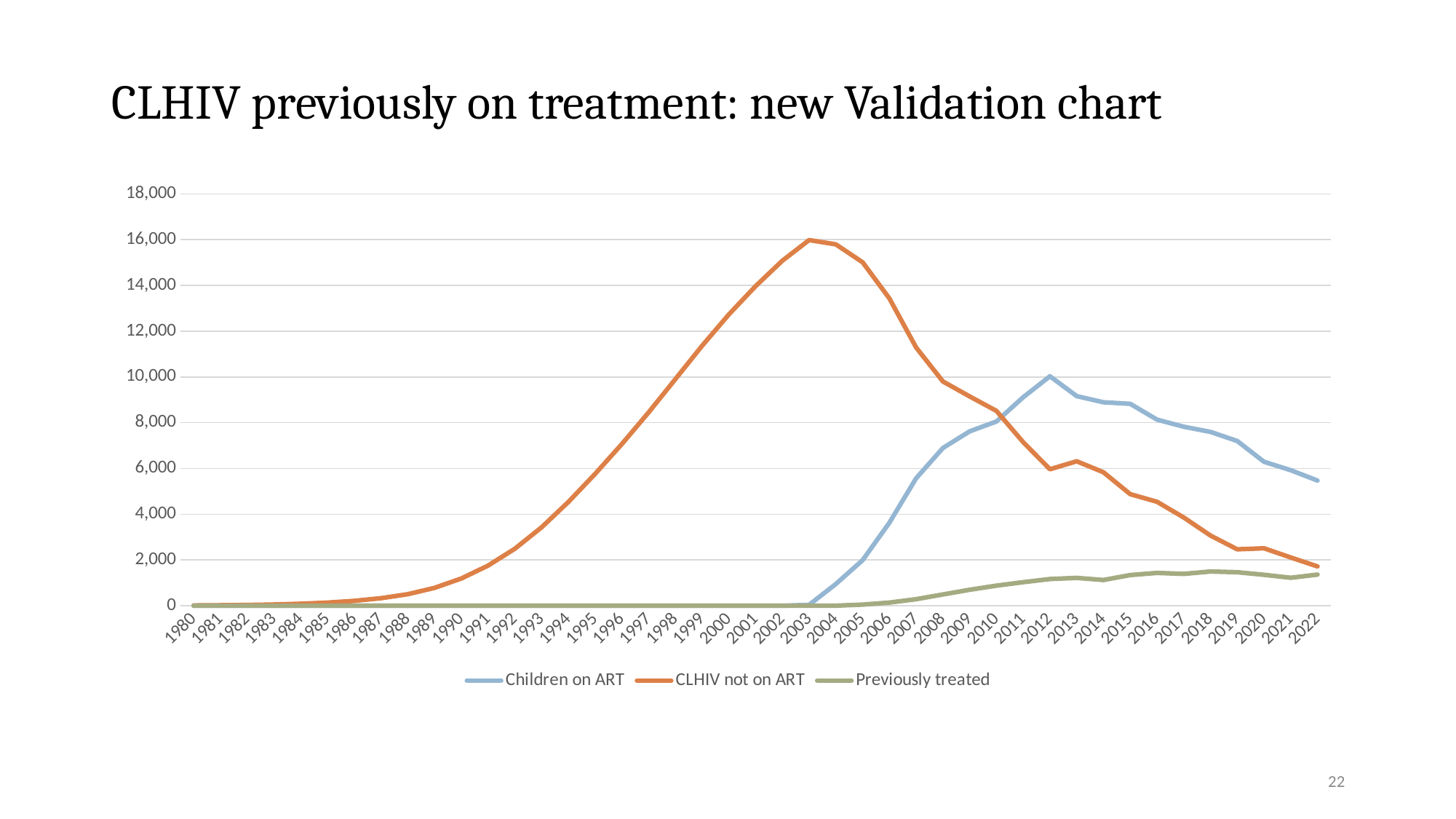
Is the value for CLHIV not on ART in 2003 greater or less than 14,000? greater How many series does the legend list? 3 In which year does the CLHIV not on ART series reach its highest value? 2003 Is the value for Children on ART in 2012 greater or less than 8,000? greater Which series has the larger value in 2000, Children on ART or CLHIV not on ART? CLHIV not on ART How many years are shown along the x axis? 43 Which series has the larger value in 2022, Children on ART or CLHIV not on ART? Children on ART Is the value for CLHIV not on ART in 2022 greater or less than 4,000? less What kind of chart is shown on the slide? Line chart Does the CLHIV not on ART series rise or fall between 2003 and 2022? Fall What is the title of the slide containing the chart? CLHIV previously on treatment: new Validation chart In which year does the Children on ART series reach its highest value? 2012